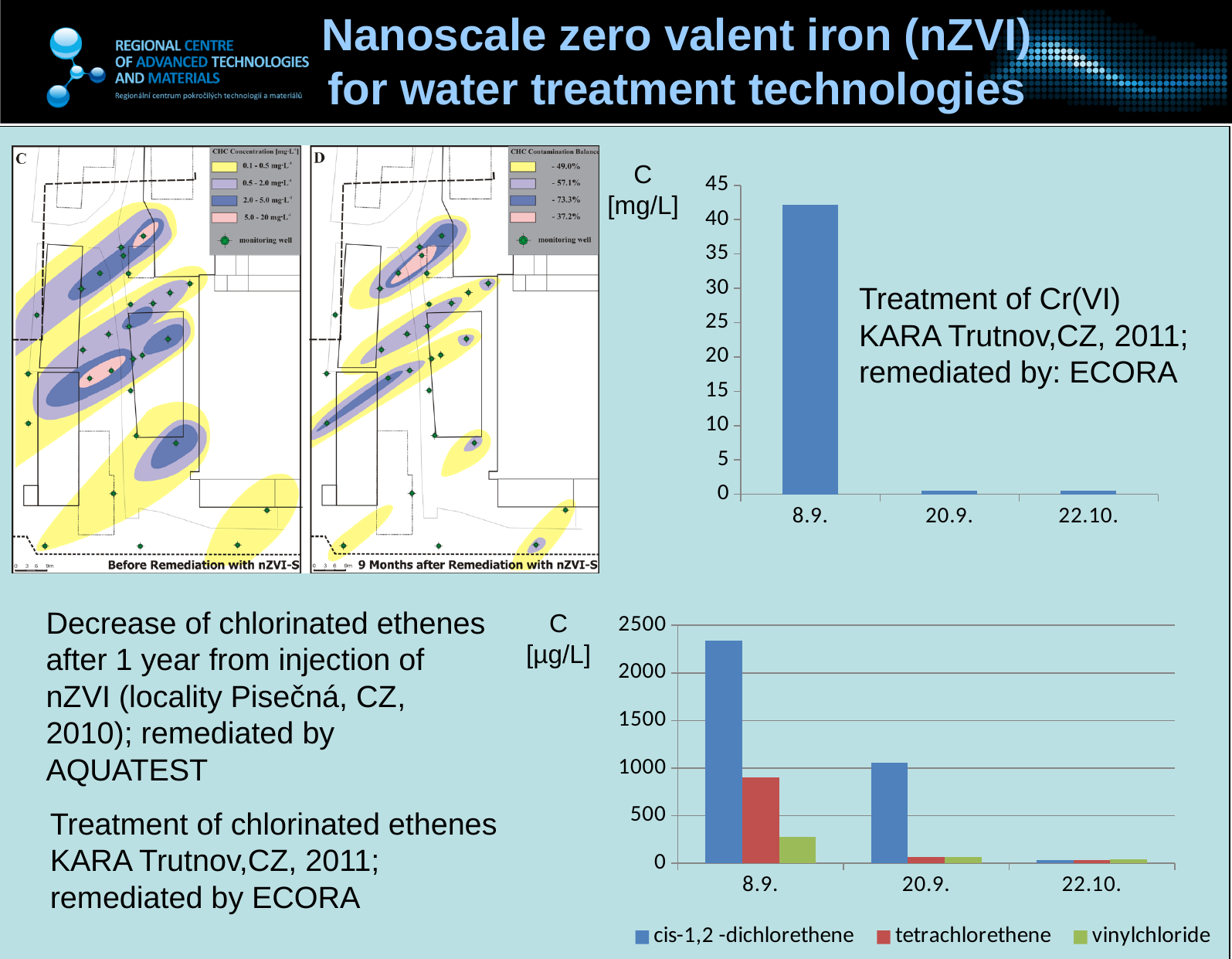
In the bottom-right chart (chlorinated ethenes), do the cis-1,2 -dichlorethene values rise or fall from 8.9. to 22.10.? fall In the top-right chart (Treatment of Cr(VI)), how many dates are shown on the x axis? 3 In the bottom-right chart (chlorinated ethenes), is the value of cis-1,2 -dichlorethene on 8.9. greater or less than 2000? greater What kind of chart is the top-right chart (Treatment of Cr(VI))? bar chart In the bottom-right chart (chlorinated ethenes), which is larger on 8.9.: tetrachlorethene or vinylchloride? tetrachlorethene In the bottom-right chart (chlorinated ethenes), how many series does the legend list? 3 In the bottom-right chart (chlorinated ethenes), which series has the highest value on 8.9.? cis-1,2 -dichlorethene In the top-right chart (Treatment of Cr(VI)), is the value for 8.9. greater or less than 40? greater In the top-right chart (Treatment of Cr(VI)), which date has the highest value? 8.9. In the top-right chart (Treatment of Cr(VI)), is the value for 20.9. greater or less than 5? less In the top-right chart (Treatment of Cr(VI)), what unit is given for the y axis? mg/L